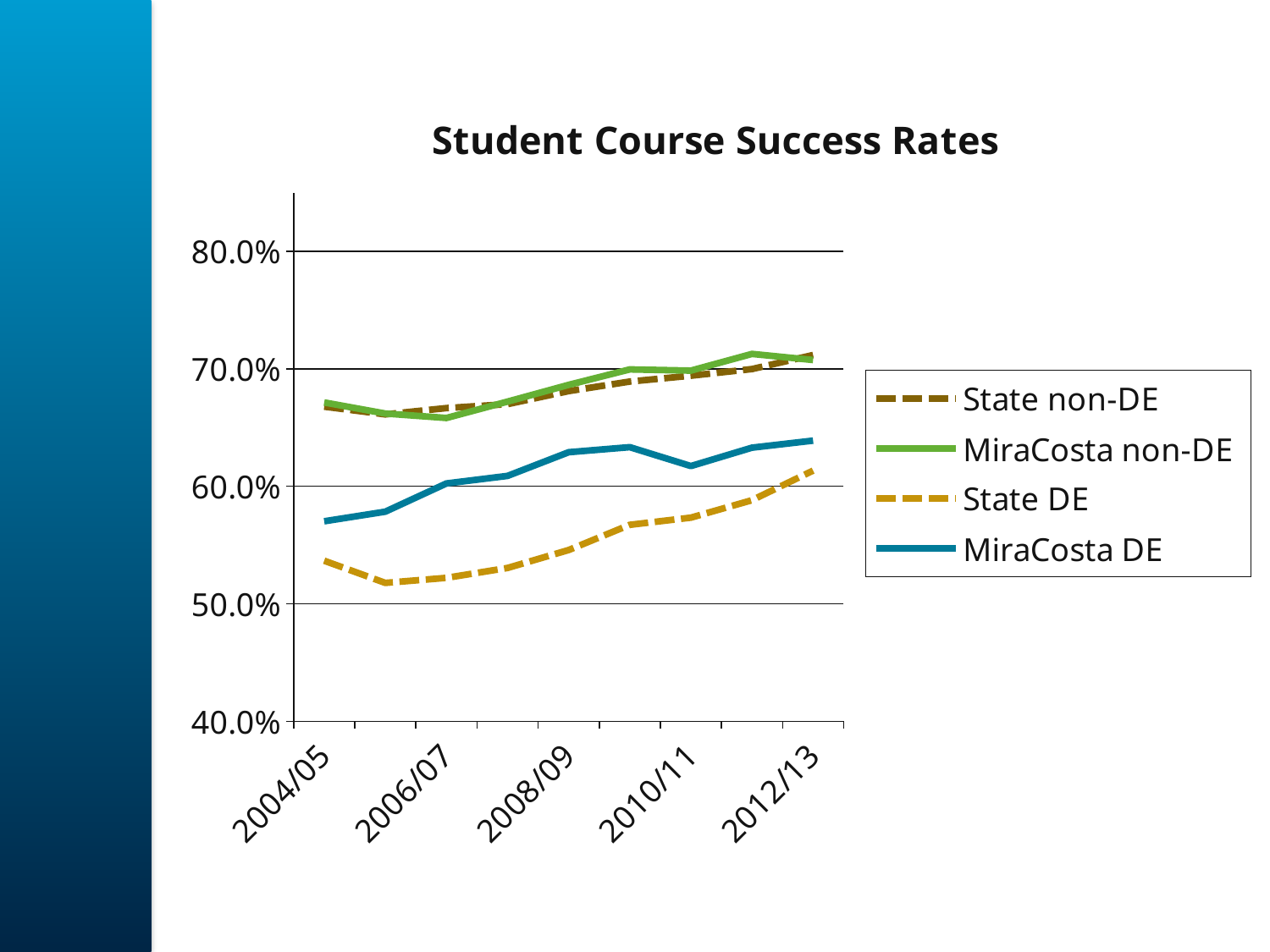
In 2004/05, which is larger: the value for MiraCosta DE or the value for State DE? MiraCosta DE How many series does the legend list? 4 Which series has the lowest values across the whole period shown? State DE Is the value for State DE in 2006/07 greater or less than 50.0%? greater What kind of chart is shown on the slide? line chart Is the value for MiraCosta DE in 2012/13 greater or less than 60.0%? greater Is the value for MiraCosta non-DE in 2012/13 greater or less than 70.0%? greater Which series is drawn as a solid green line? MiraCosta non-DE What is the title of the chart? Student Course Success Rates Does the State DE line generally rise or fall from 2006/07 to 2012/13? rise How many year labels are shown on the x axis? 5